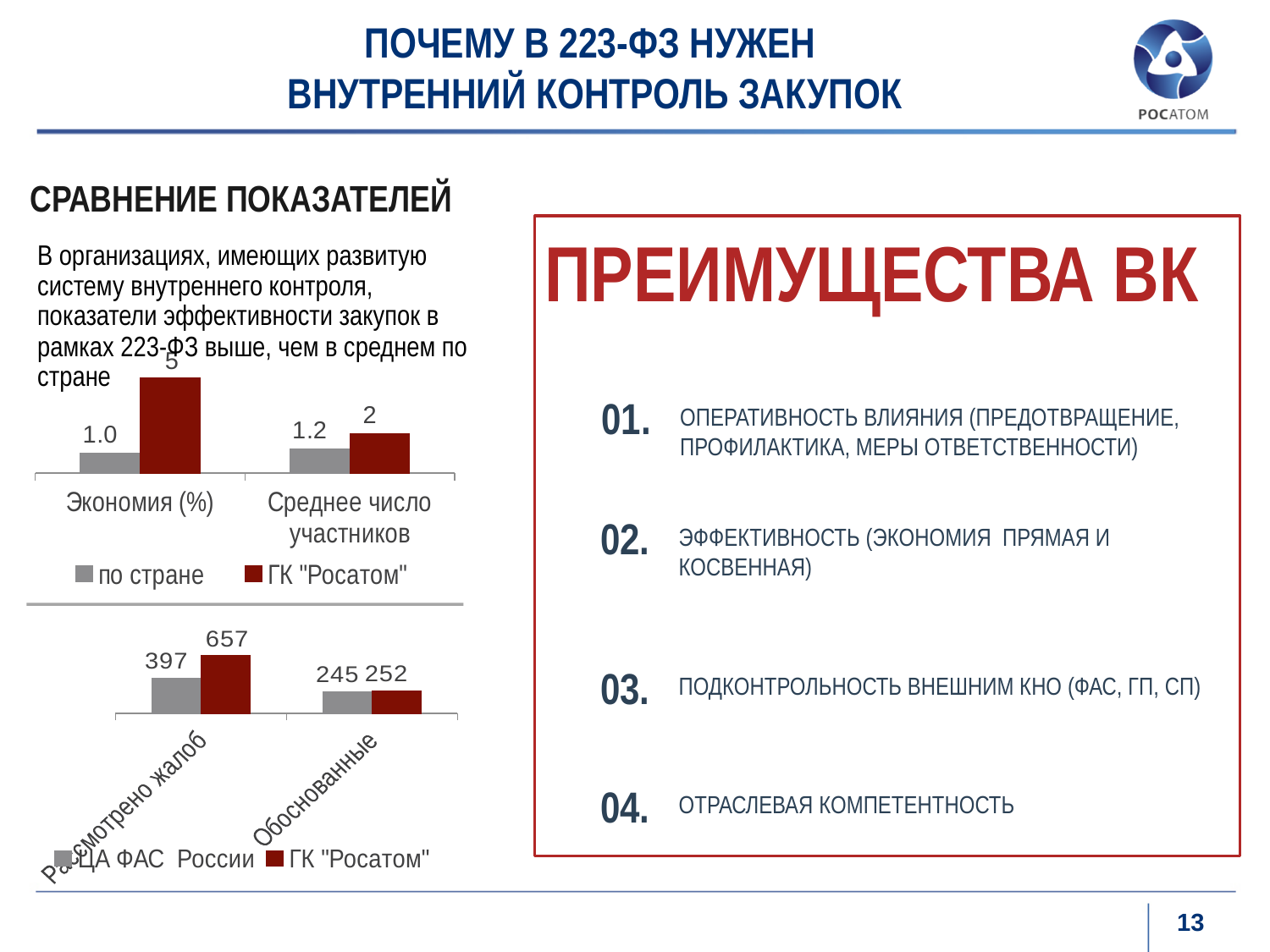
In the top chart, what is the value for по стране in the Экономия (%) category? 1.0 In the top chart, how many series does the legend list? 2 In the top chart, what is the value for ГК "Росатом" in the Экономия (%) category? 5 In the bottom chart, what is the difference between the two values in the Обоснованные category? 7 In the bottom chart, what is the difference between the two values in the first category (657 and 397)? 260 In the top chart, which series has the larger value in the Экономия (%) category? ГК "Росатом" In the bottom chart, what is the value for ГК "Росатом" in the Обоснованные category? 252 What kind of chart is the top chart? Bar chart In the top chart, what is the value for ГК "Росатом" in the Среднее число участников category? 2 In the top chart, what is the value for по стране in the Среднее число участников category? 1.2 In the bottom chart, which bar is the highest? ГК "Росатом" in the first category (657) In the bottom chart, what is the value for ГК "Росатом" in the first category? 657